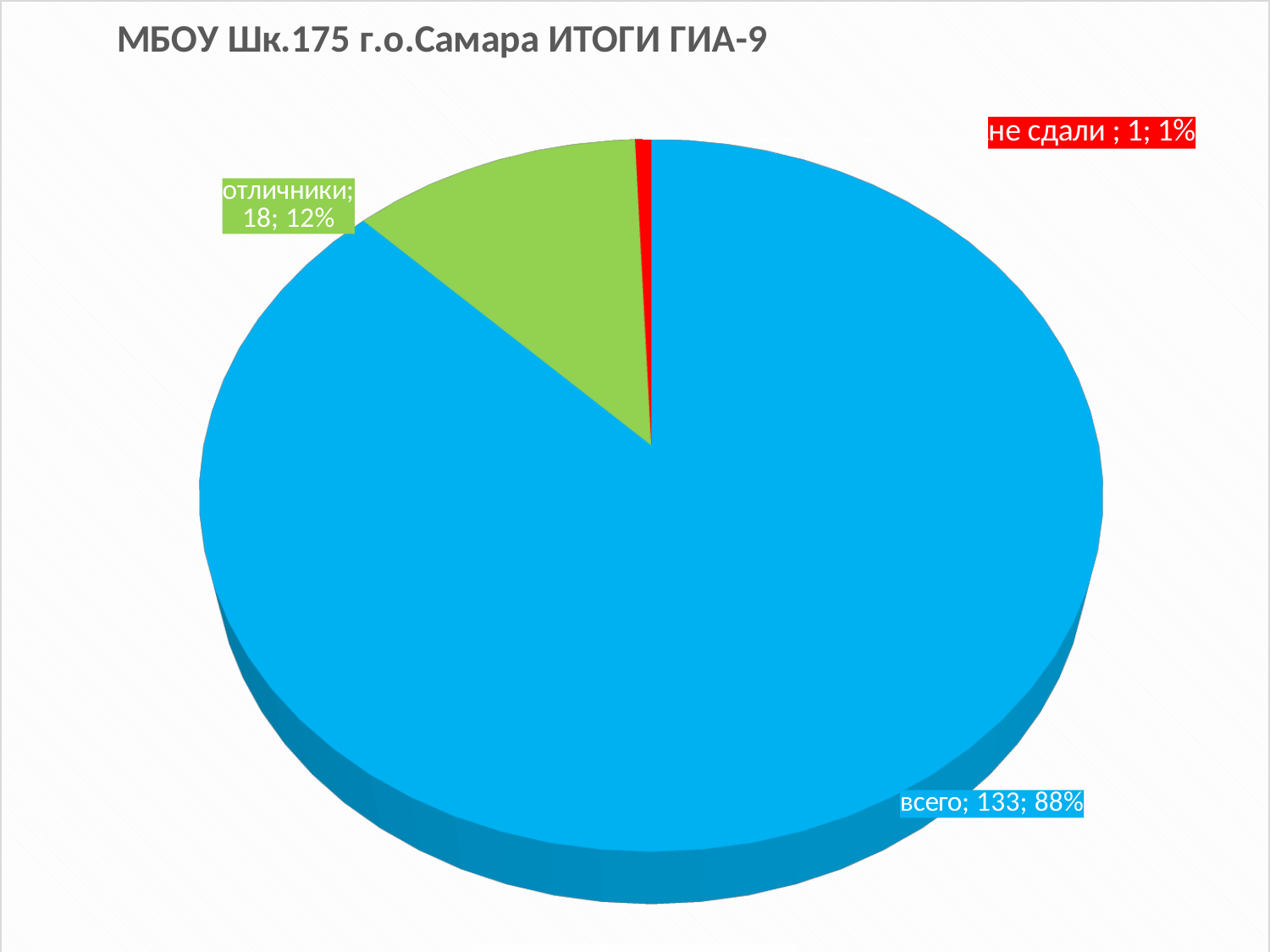
Which slice is the smallest? не сдали What colour is the "не сдали" slice? red What share of the pie does the "отличники" slice represent? 12% What is the value for the slice labelled "не сдали"? 1 What is the difference between the values for "всего" and "отличники"? 115 What is the value for the slice labelled "отличники"? 18 What share of the pie does the "всего" slice represent? 88% How many slices does the pie chart have? 3 What kind of chart is shown on the slide? pie chart What is the title of the chart? МБОУ Шк.175 г.о.Самара ИТОГИ ГИА-9 Which slice is the largest? всего What is the value for the slice labelled "всего"? 133